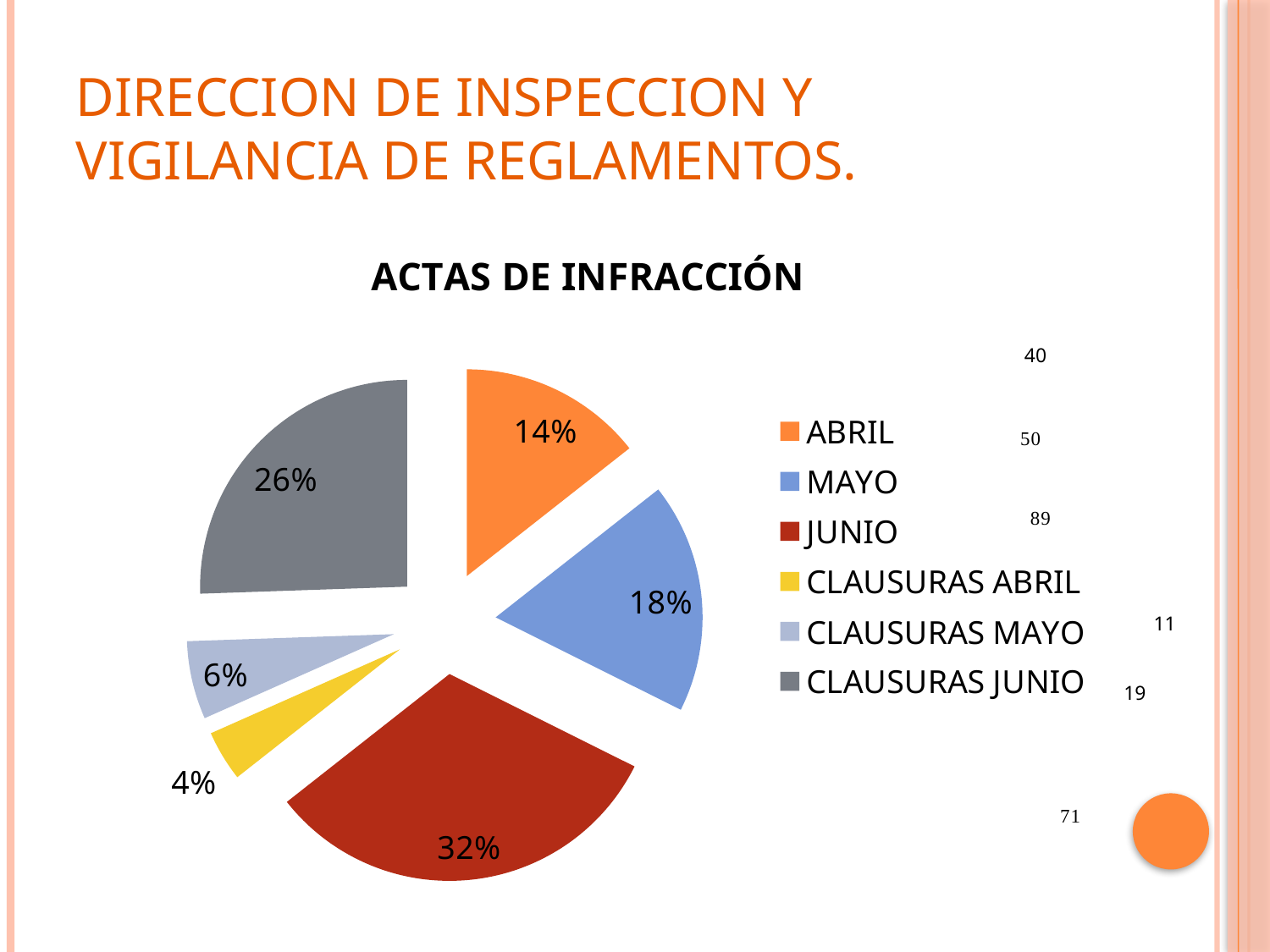
Which category has the largest share of the pie? JUNIO Which is larger, the share for MAYO or the share for CLAUSURAS JUNIO? CLAUSURAS JUNIO Which category has the smallest share of the pie? CLAUSURAS ABRIL What percentage of the pie does ABRIL represent? 14% How many categories does the legend list? 6 What percentage of the pie does JUNIO represent? 32% What percentage of the pie does CLAUSURAS MAYO represent? 6% What is the difference in percentage points between JUNIO and MAYO? 14 What type of chart is shown on the slide? Pie chart What is the title of the chart? ACTAS DE INFRACCIÓN What percentage of the pie does CLAUSURAS JUNIO represent? 26% What colour is the slice for CLAUSURAS ABRIL? Yellow